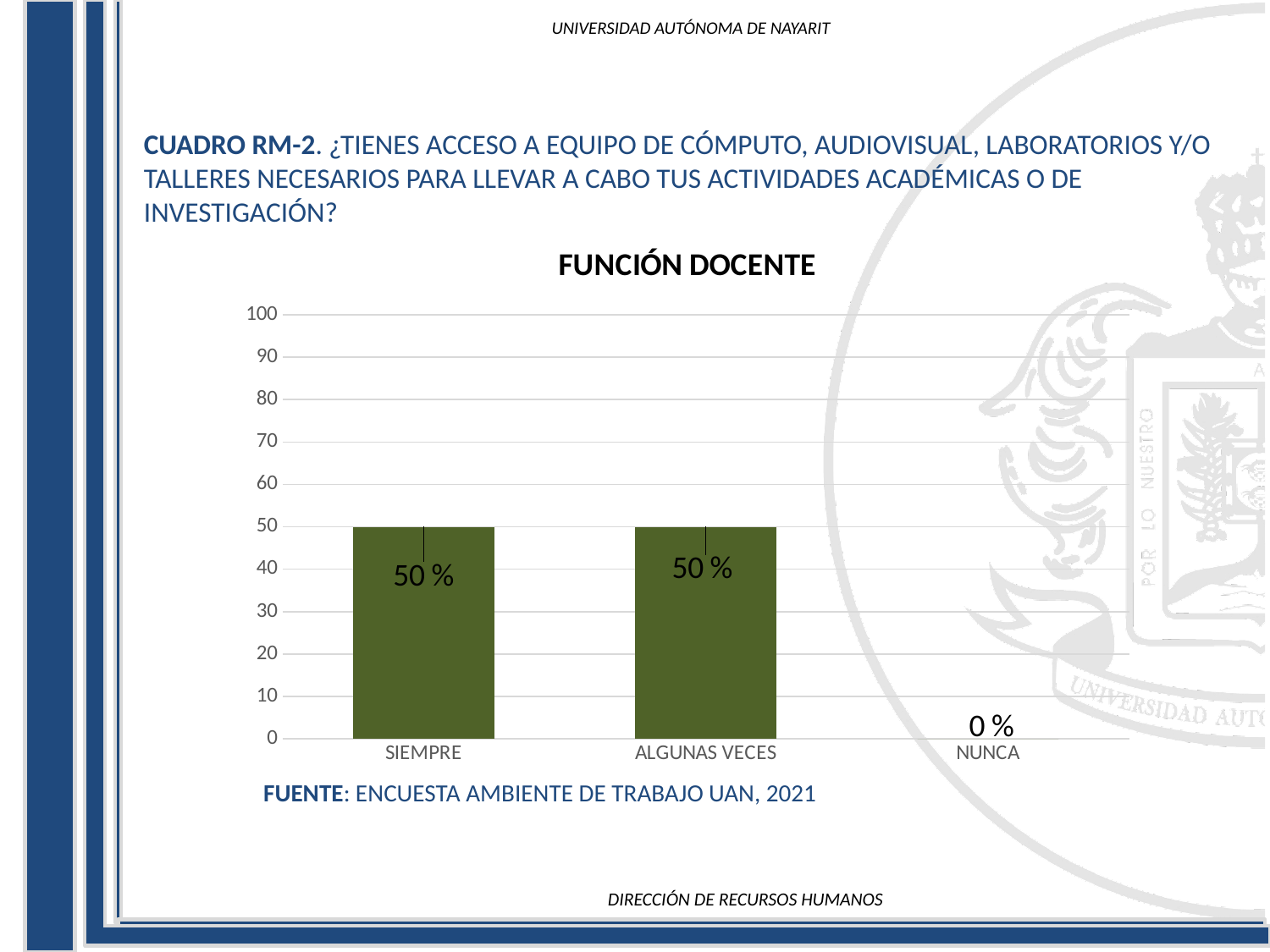
What is the value for ALGUNAS VECES? 50 % What is the total of the values for SIEMPRE and ALGUNAS VECES? 100 % What kind of chart is shown on the slide? bar chart How many categories are shown on the x axis? 3 Which category has the lowest value? NUNCA What is the highest value shown on the y axis? 100 What is the value for NUNCA? 0 % What is the value for SIEMPRE? 50 % What is the difference between the values for SIEMPRE and NUNCA? 50 % What is the title of the chart? FUNCIÓN DOCENTE Which is larger, the value for ALGUNAS VECES or the value for NUNCA? ALGUNAS VECES Is the value for SIEMPRE greater or less than 60? less